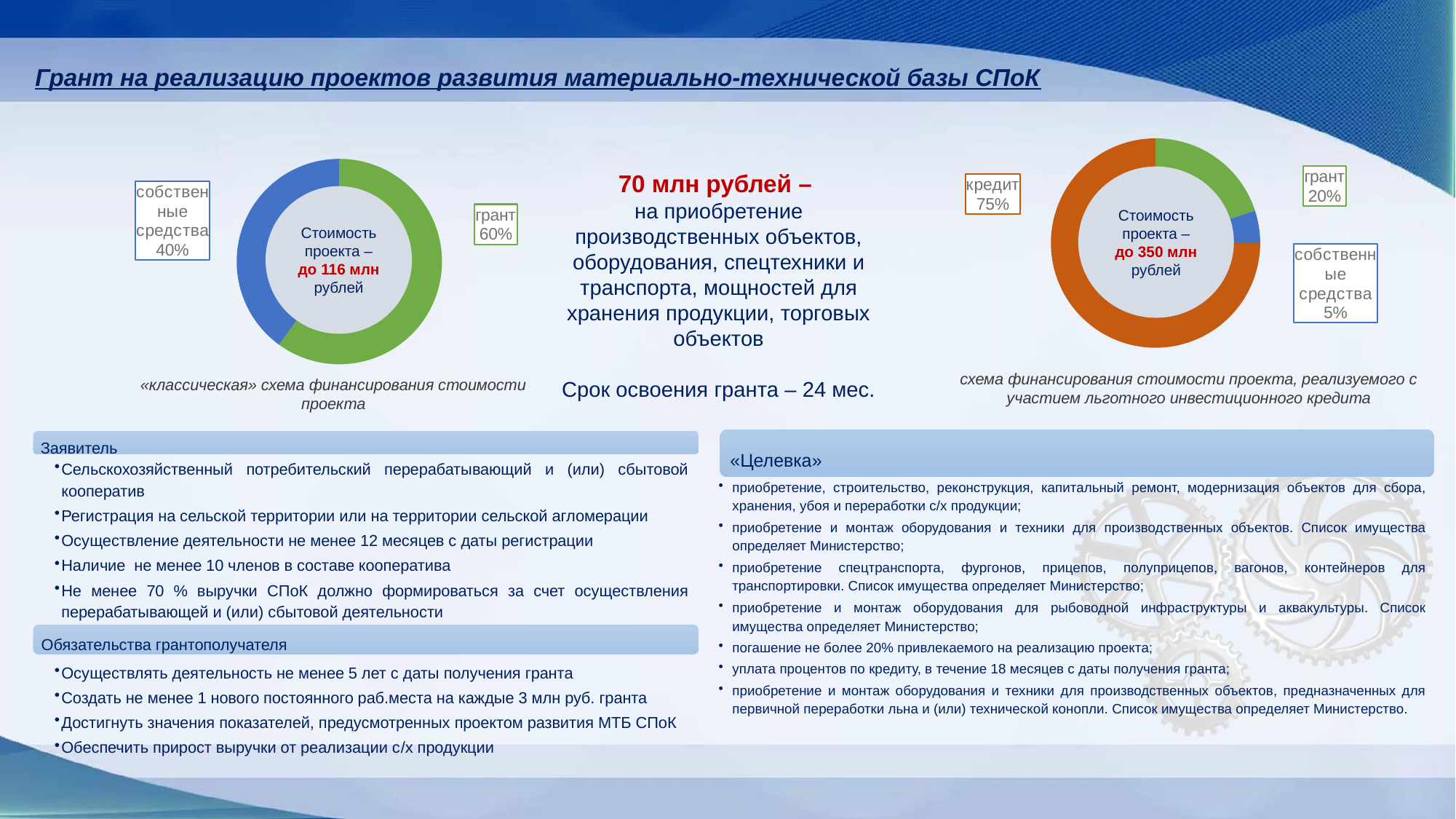
На правой диаграмме (схема с участием льготного инвестиционного кредита) какая доля приходится на собственные средства? 5% Какого типа диаграмма слева («классическая» схема финансирования стоимости проекта)? кольцевая (круговая) диаграмма На левой диаграмме («классическая» схема финансирования стоимости проекта) какая доля приходится на грант? 60% На правой диаграмме (схема с участием льготного инвестиционного кредита) какой источник финансирования имеет наименьшую долю? собственные средства Сколько сегментов на правой диаграмме (схема с участием льготного инвестиционного кредита)? 3 На правой диаграмме (схема с участием льготного инвестиционного кредита) какая доля приходится на грант? 20% На левой диаграмме («классическая» схема финансирования) какая доля приходится на собственные средства? 40% На правой диаграмме (схема с участием льготного инвестиционного кредита) какой источник финансирования имеет наибольшую долю? кредит На правой диаграмме (схема с участием льготного инвестиционного кредита) какая доля приходится на кредит? 75% На левой диаграмме («классическая» схема финансирования) что больше: доля гранта или доля собственных средств? грант На левой диаграмме («классическая» схема финансирования) на сколько процентных пунктов доля гранта больше доли собственных средств? 20% На правой диаграмме (схема с участием льготного инвестиционного кредита) на сколько процентных пунктов доля кредита больше доли гранта? 55%